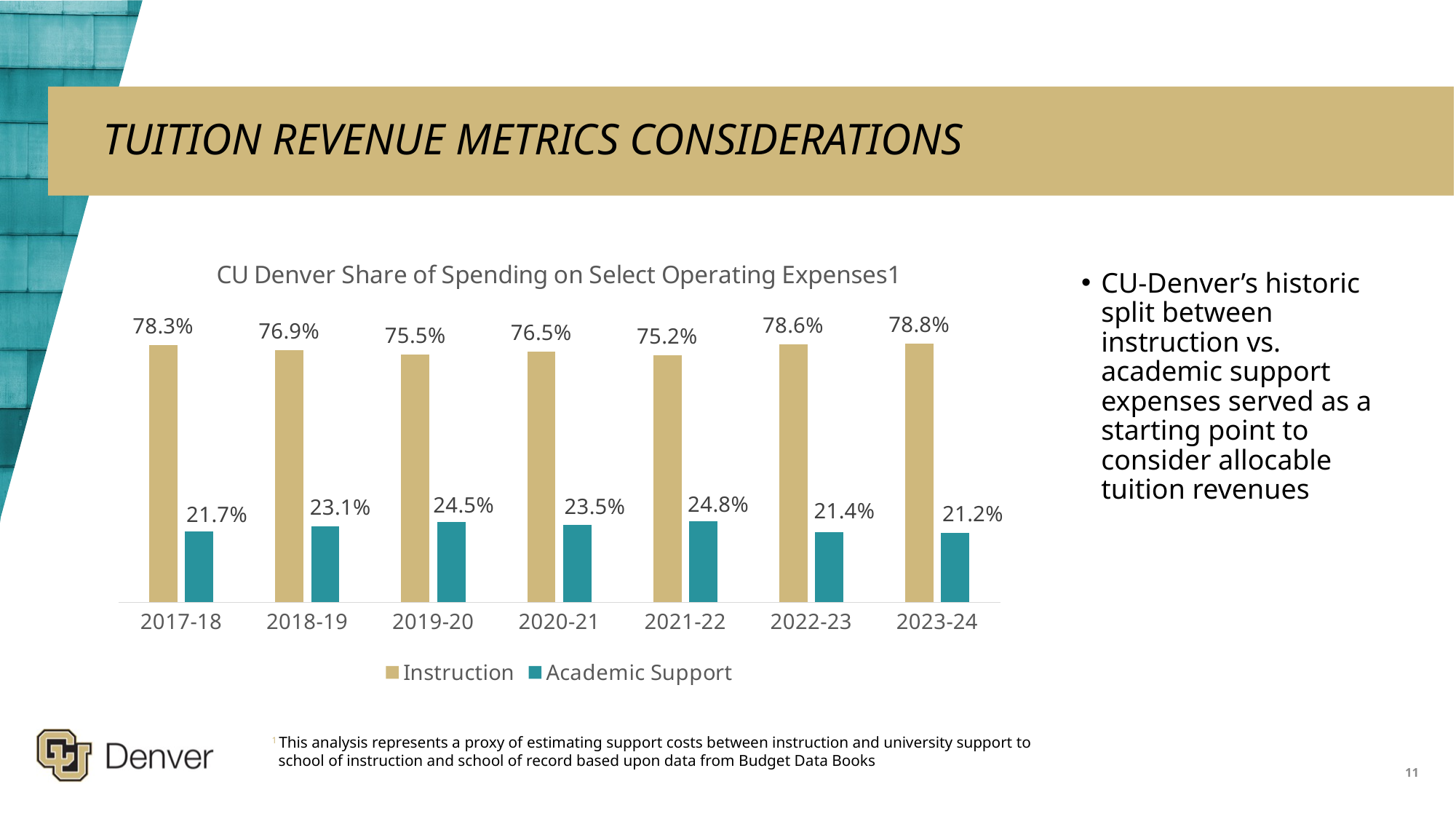
What is the Academic Support share for 2021-22? 24.8% Is the Academic Support share larger in 2018-19 or in 2022-23? 2018-19 How many years are shown on the x axis? 7 What is the difference between the Instruction and Academic Support shares in 2019-20? 51.0% What is the title of the chart? CU Denver Share of Spending on Select Operating Expenses1 What is the Instruction share for 2023-24? 78.8% What kind of chart is shown? Bar chart How many series does the legend list? 2 What is the Instruction share for 2017-18? 78.3% Which year has the highest Instruction share? 2023-24 Which year has the lowest Academic Support share? 2023-24 Which year has the highest Academic Support share? 2021-22